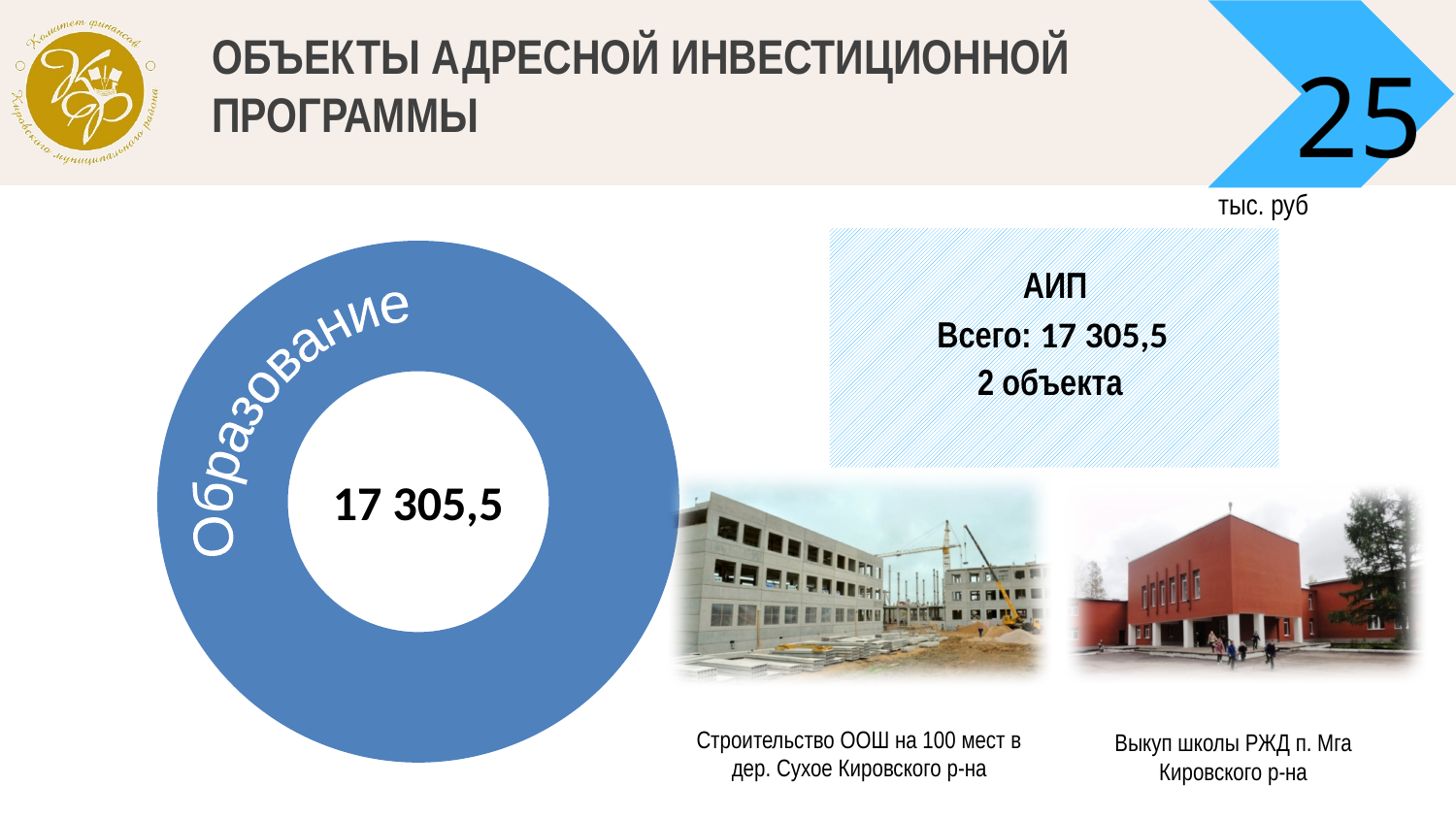
Is the value for Образование in the doughnut chart greater or less than 10 000? greater What is the name of the only category in the doughnut chart? Образование How many categories does the doughnut chart contain? 1 What value is printed in the centre of the doughnut chart? 17 305,5 What is the value shown for Образование in the doughnut chart? 17 305,5 What kind of chart is shown on the slide? doughnut chart What unit is indicated for the values on the slide? тыс. руб What share of the doughnut chart does Образование occupy? 100%